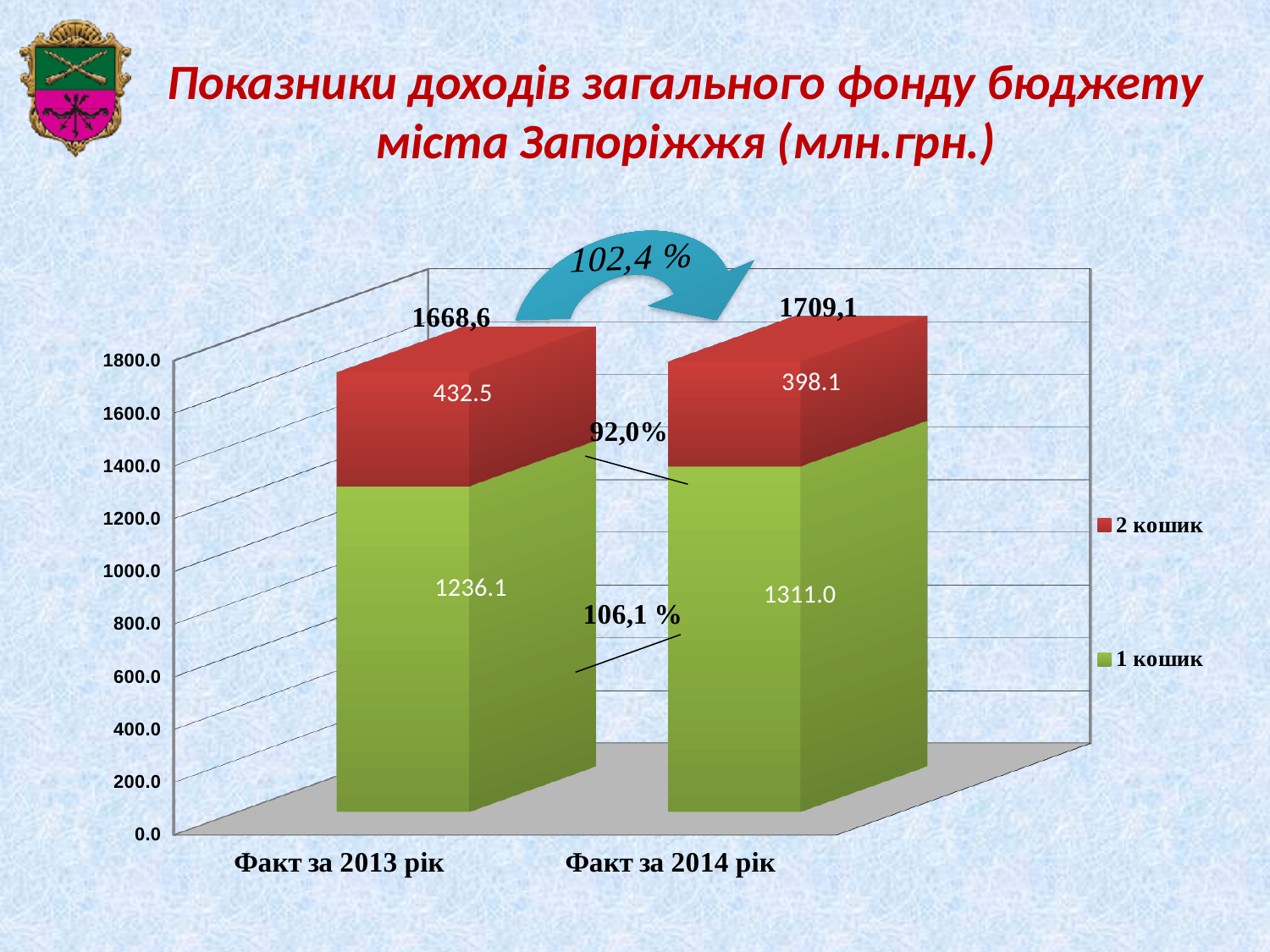
What kind of chart is shown on the slide? stacked bar chart What is the value of "1 кошик" for "Факт за 2013 рік"? 1236.1 What is the value of "2 кошик" for "Факт за 2014 рік"? 398.1 What is the total shown above the stacked bar for "Факт за 2014 рік"? 1709,1 What is the value of "2 кошик" for "Факт за 2013 рік"? 432.5 Which category has the higher value for "2 кошик"? Факт за 2013 рік How many series does the legend list? 2 What is the value of "1 кошик" for "Факт за 2014 рік"? 1311.0 Is the "1 кошик" value for "Факт за 2014 рік" larger or smaller than the "1 кошик" value for "Факт за 2013 рік"? larger What is the total shown above the stacked bar for "Факт за 2013 рік"? 1668,6 Which category has the lower value for "1 кошик"? Факт за 2013 рік What is the difference between the "1 кошик" values for 2014 and 2013? 74.9